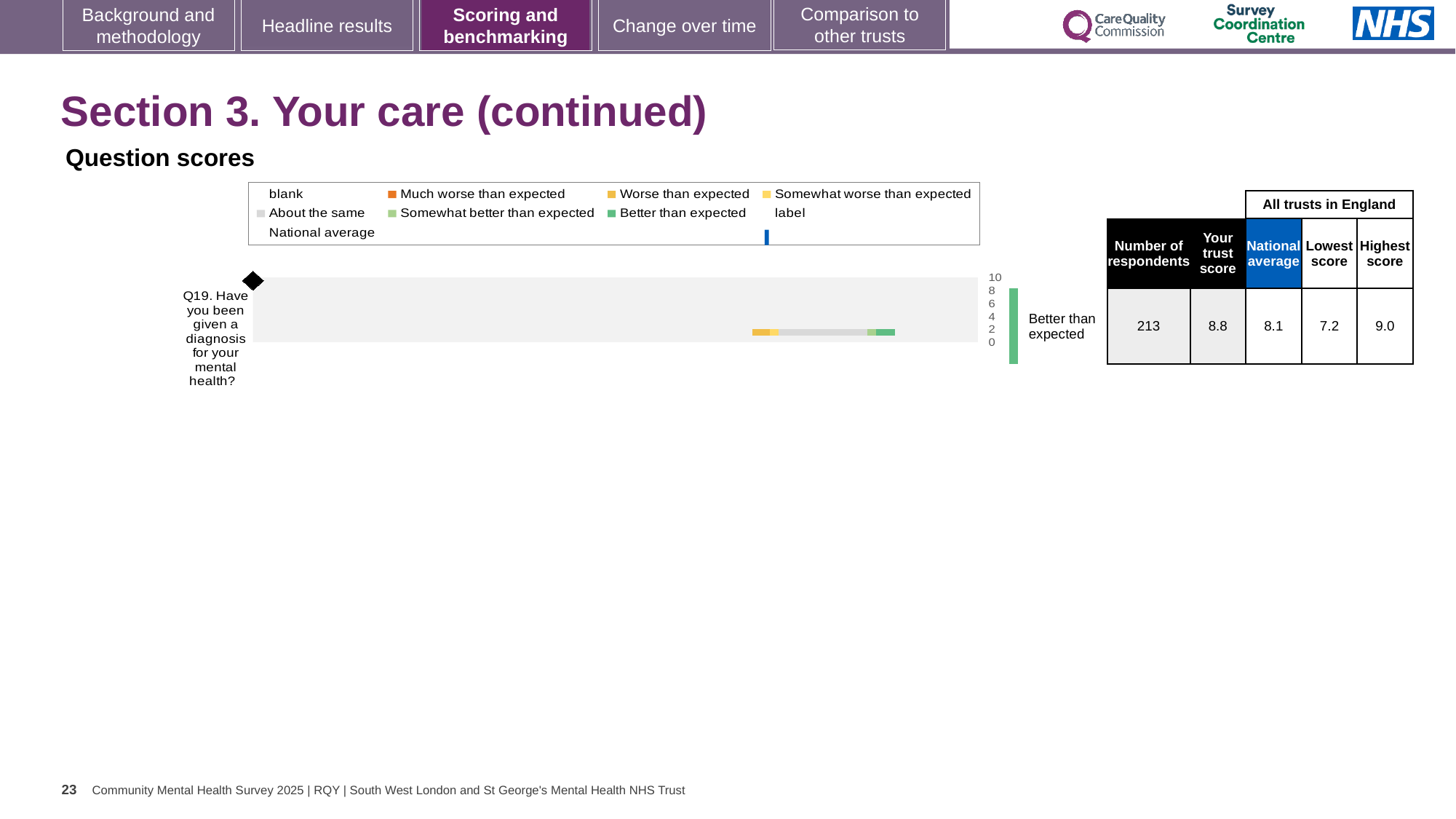
What kind of chart is used to show the question scores? Bar chart What is the national average score for Q19? 8.1 Is the trust's score for Q19 greater or less than 8? greater How many respondents answered Q19? 213 By how much does the trust's score for Q19 exceed the national average? 0.7 Which is larger for Q19: the trust's score or the national average? The trust's score (8.8) Which benchmark category is the trust's Q19 score placed in? Better than expected What is the difference between the highest and lowest scores for Q19 across all trusts in England? 1.8 What is the trust's score for Q19 (Have you been given a diagnosis for your mental health?)? 8.8 How many questions are plotted in the Question scores chart? 1 What is the lowest score among all trusts in England for Q19? 7.2 What is the highest score among all trusts in England for Q19? 9.0